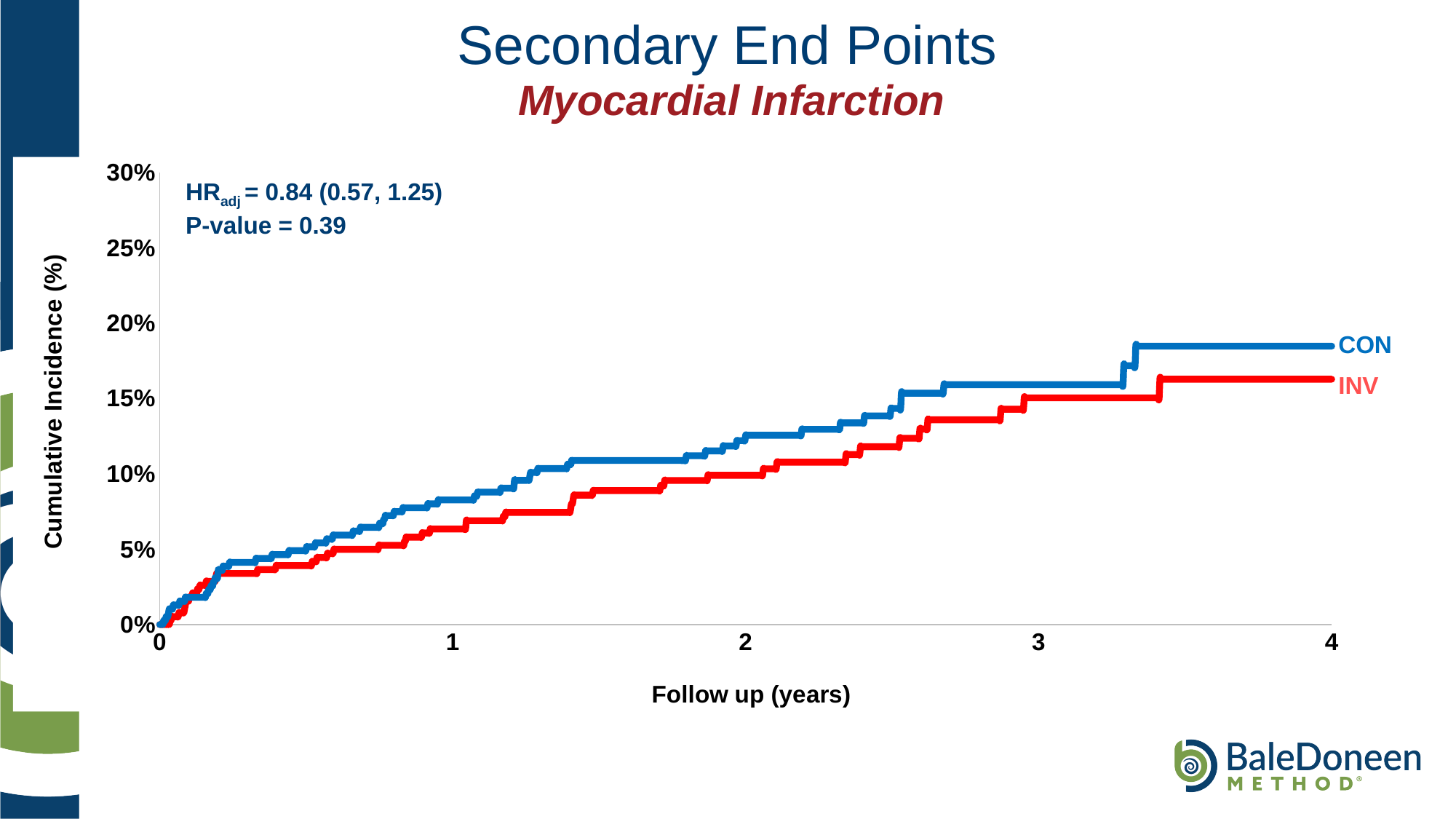
How many series are plotted on the chart? 2 Is the cumulative incidence for CON at 2 years greater or less than 10%? greater What P-value is printed on the chart? 0.39 Is the cumulative incidence for CON at 4 years greater or less than 15%? greater What is the label of the x axis? Follow up (years) What are the names of the two series plotted on the chart? CON and INV Which series has the higher cumulative incidence at 4 years of follow up, CON or INV? CON Which series has the higher cumulative incidence at 1 year of follow up, CON or INV? CON Is the cumulative incidence for CON at 4 years greater or less than 20%? less Do the cumulative incidence values rise or fall as follow-up time increases? rise What kind of chart is shown on the slide? line chart